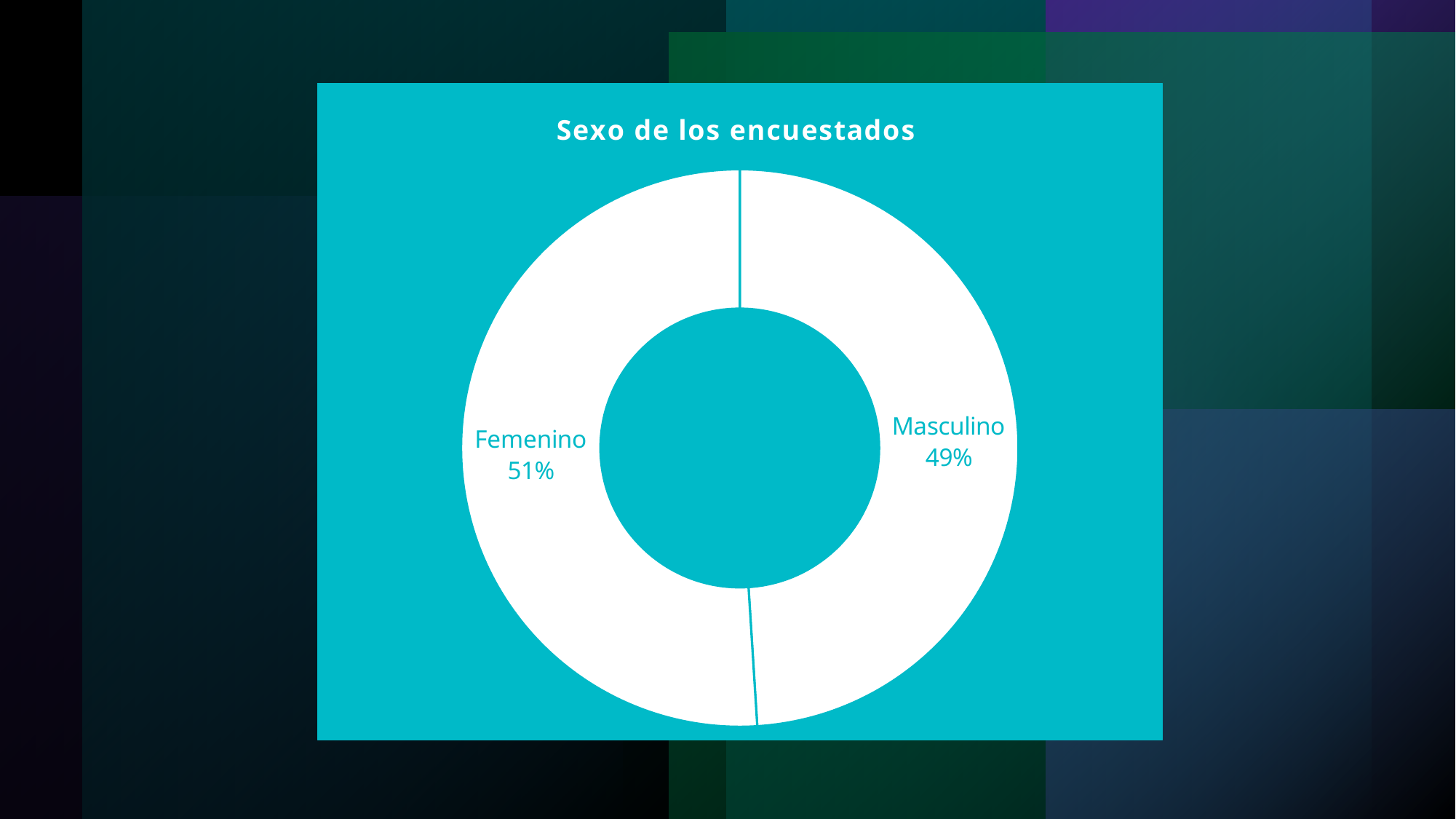
How many categories are shown in the chart? 2 What is the title of the chart? Sexo de los encuestados Is the value for Femenino greater or less than 50%? greater Which category has the larger share, Femenino or Masculino? Femenino What share of the chart does the Masculino slice represent? 49% What kind of chart is shown on the slide? Doughnut (pie) chart Which category has the largest share? Femenino Which category has the smallest share? Masculino What percentage of respondents are Femenino? 51% What colour are the slices of the chart? White What is the difference in percentage points between Femenino and Masculino? 2 percentage points What percentage of respondents are Masculino? 49%